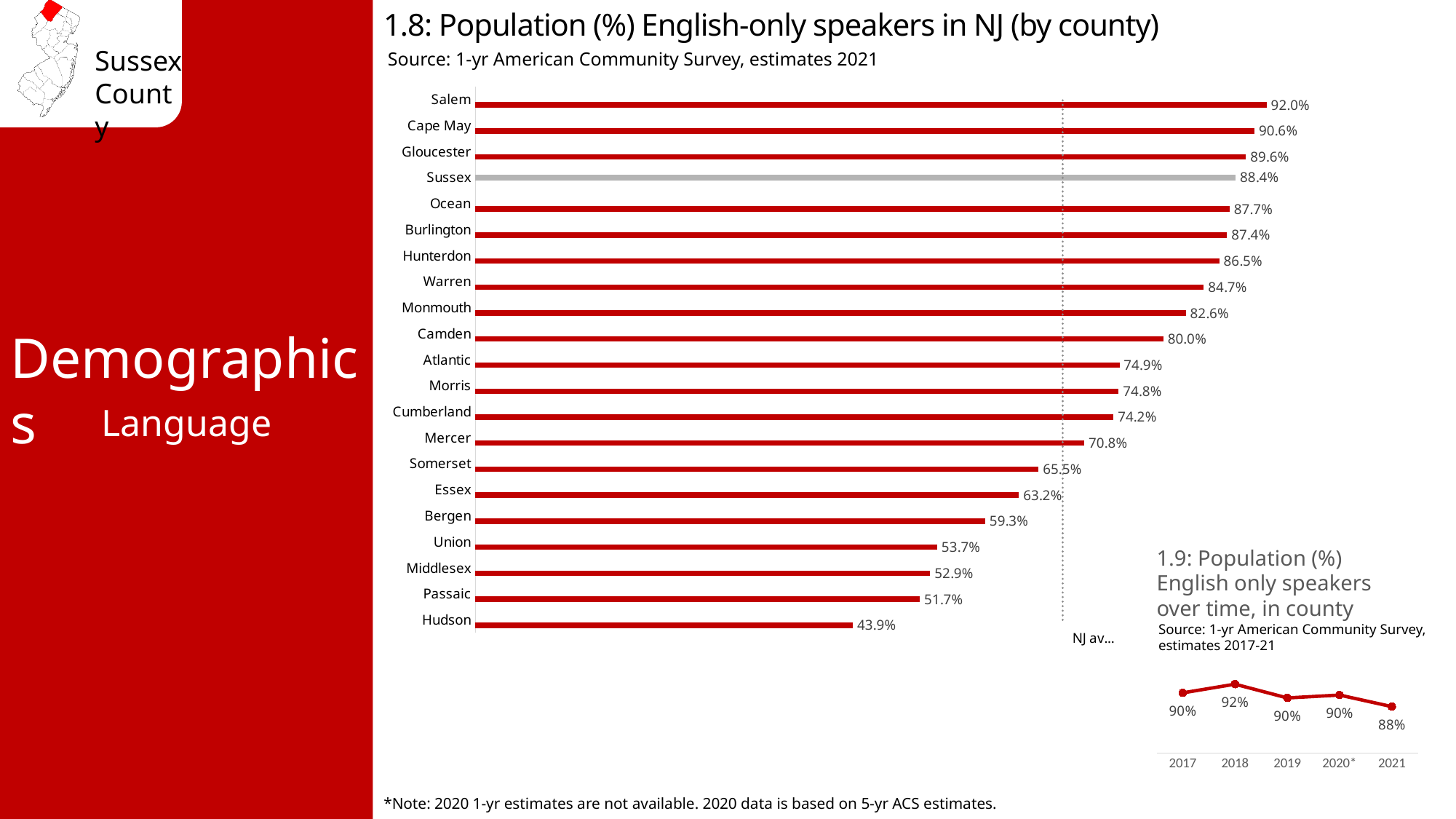
In chart 1.8, how many counties are plotted? 21 In chart 1.8, which has a higher value, Warren or Monmouth? Warren In chart 1.8, which county's bar is shown in grey instead of red? Sussex In chart 1.8 (Population (%) English-only speakers in NJ by county), what is the value for Sussex? 88.4% In chart 1.8, which county has the lowest percentage of English-only speakers? Hudson What kind of chart is chart 1.9? Line chart In chart 1.9, how many years are plotted? 5 In chart 1.8, what is the difference between the values for Salem and Hudson? 48.1% In chart 1.8, what is the value for Hudson? 43.9% In chart 1.9 (Population (%) English only speakers over time, in county), what is the value for 2018? 92% In chart 1.8, which county has the highest percentage of English-only speakers? Salem What kind of chart is chart 1.8? Bar chart